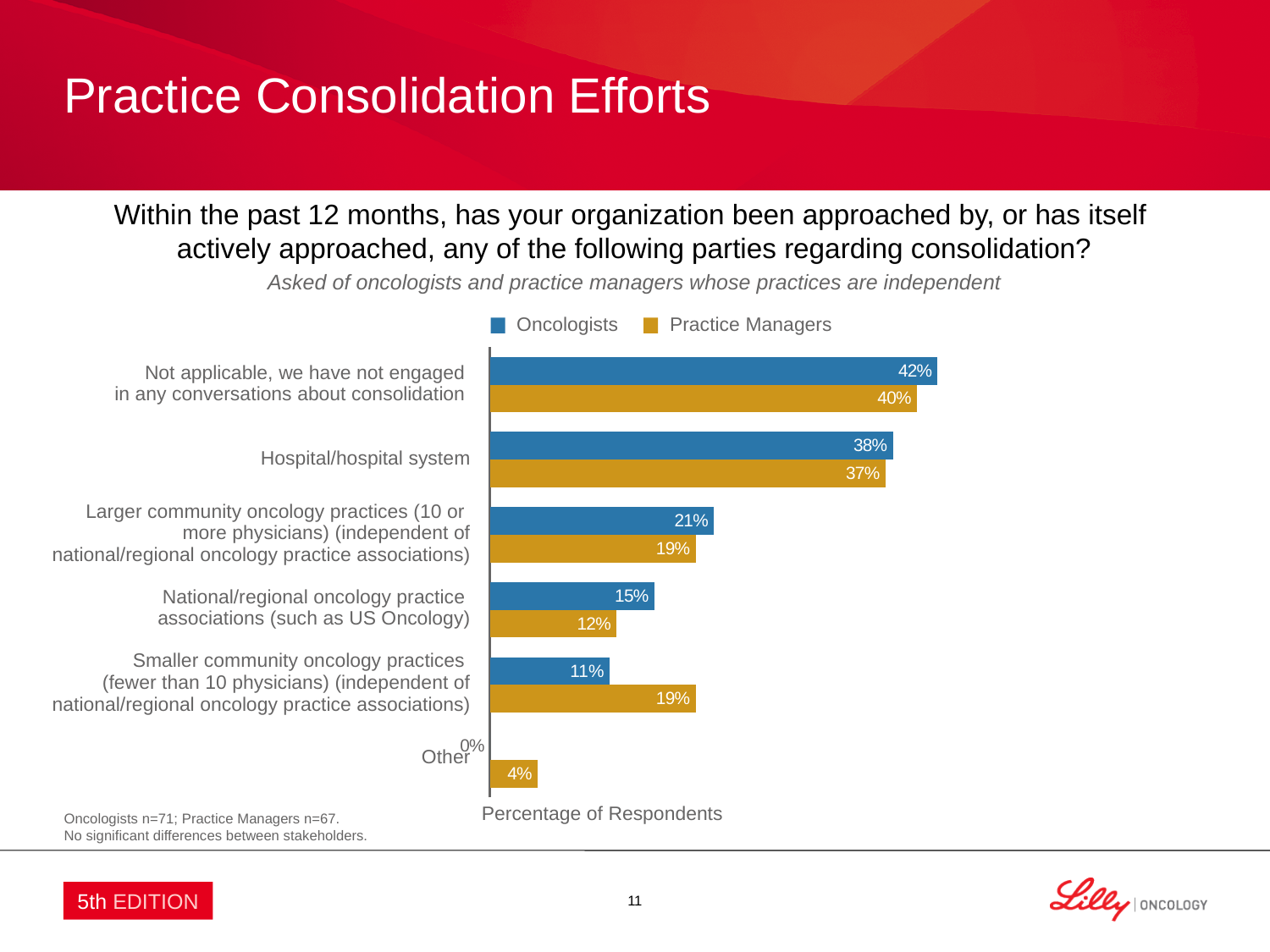
How many series does the legend list? 2 What is the difference between Oncologists and Practice Managers for Larger community oncology practices (10 or more physicians)? 2% What percentage of Oncologists selected Hospital/hospital system? 38% What is the difference between Oncologists and Practice Managers for National/regional oncology practice associations (such as US Oncology)? 3% For Smaller community oncology practices (fewer than 10 physicians), which series has the larger value, Oncologists or Practice Managers? Practice Managers Which category has the highest value for Oncologists? Not applicable, we have not engaged in any conversations about consolidation What is the label of the horizontal axis? Percentage of Respondents How many categories are shown on the chart? 6 What percentage of Practice Managers selected Smaller community oncology practices (fewer than 10 physicians)? 19% What kind of chart is shown on the slide? Bar chart Which category has the lowest value for Practice Managers? Other What percentage of Practice Managers selected Other? 4%